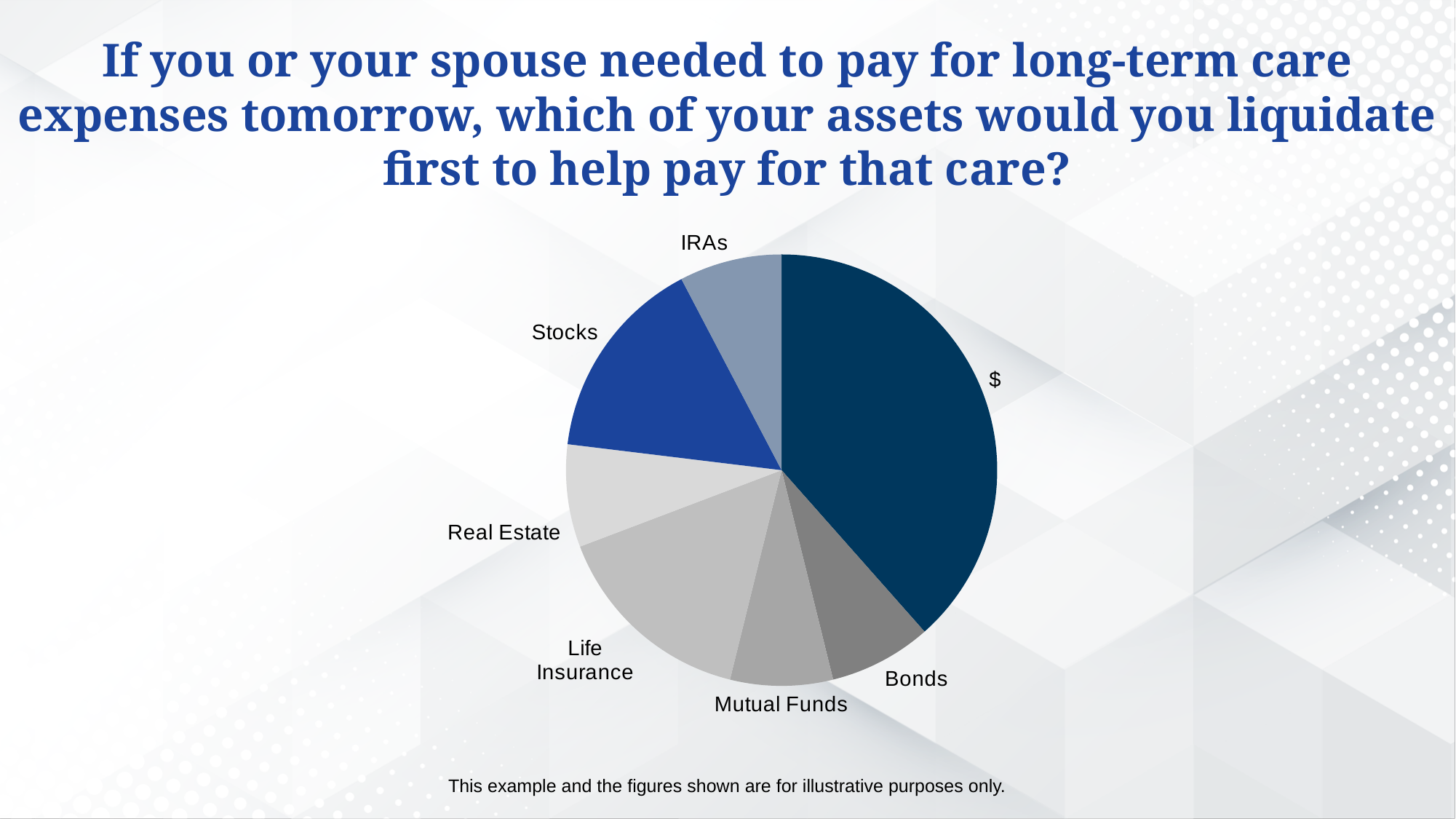
What kind of chart is shown on the slide? Pie chart Which slice is larger, $ or Stocks? $ Which slice is larger, Stocks or IRAs? Stocks Which slice is larger, $ or Real Estate? $ Which slice is labelled with a dollar sign? The largest slice How many slices does the pie chart have? 7 What does the note at the bottom of the slide say? This example and the figures shown are for illustrative purposes only. Which slice of the pie chart is the largest? $